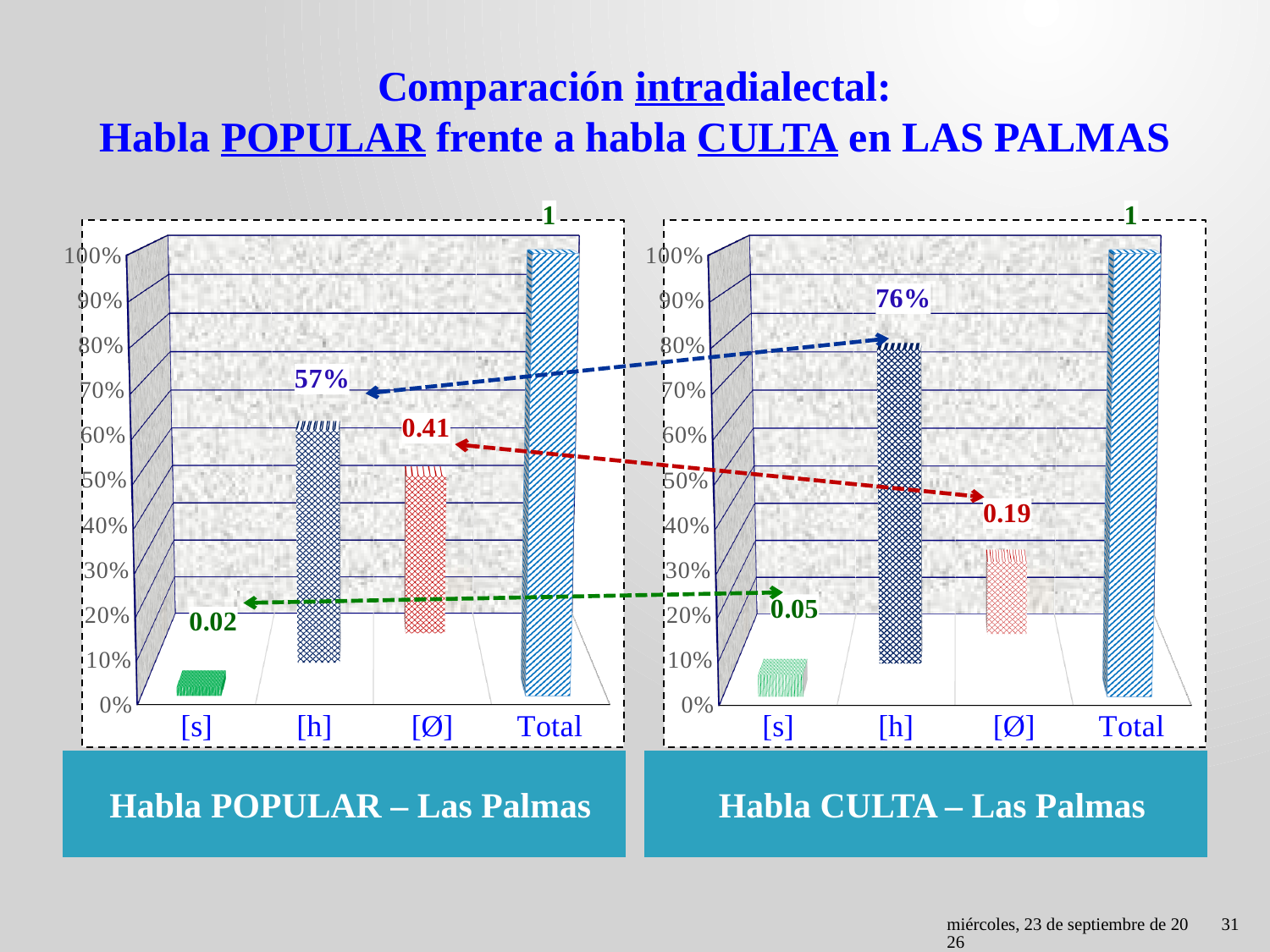
What kind of chart is the Habla CULTA – Las Palmas chart? Bar chart In the Habla CULTA – Las Palmas chart, which category has the highest bar? Total In the Habla CULTA – Las Palmas chart, is the value for [Ø] greater or less than 30%? less What is the difference between the [h] values in the Habla CULTA chart and the Habla POPULAR chart? 19% Is the [h] value larger in the Habla POPULAR chart or in the Habla CULTA chart? Habla CULTA How many categories are shown on the x axis of the Habla POPULAR – Las Palmas chart? 4 In the Habla POPULAR – Las Palmas chart, what is the value labelled for [h]? 57% In the Habla CULTA – Las Palmas chart, what is the value labelled for [s]? 0.05 In the Habla POPULAR – Las Palmas chart, which category has the lowest bar? [s] In the Habla CULTA – Las Palmas chart, what is the value labelled for [h]? 76% In the Habla POPULAR – Las Palmas chart, what is the value labelled for [Ø]? 0.41 What is the difference between the [Ø] values in the Habla POPULAR chart (0.41) and the Habla CULTA chart (0.19)? 0.22